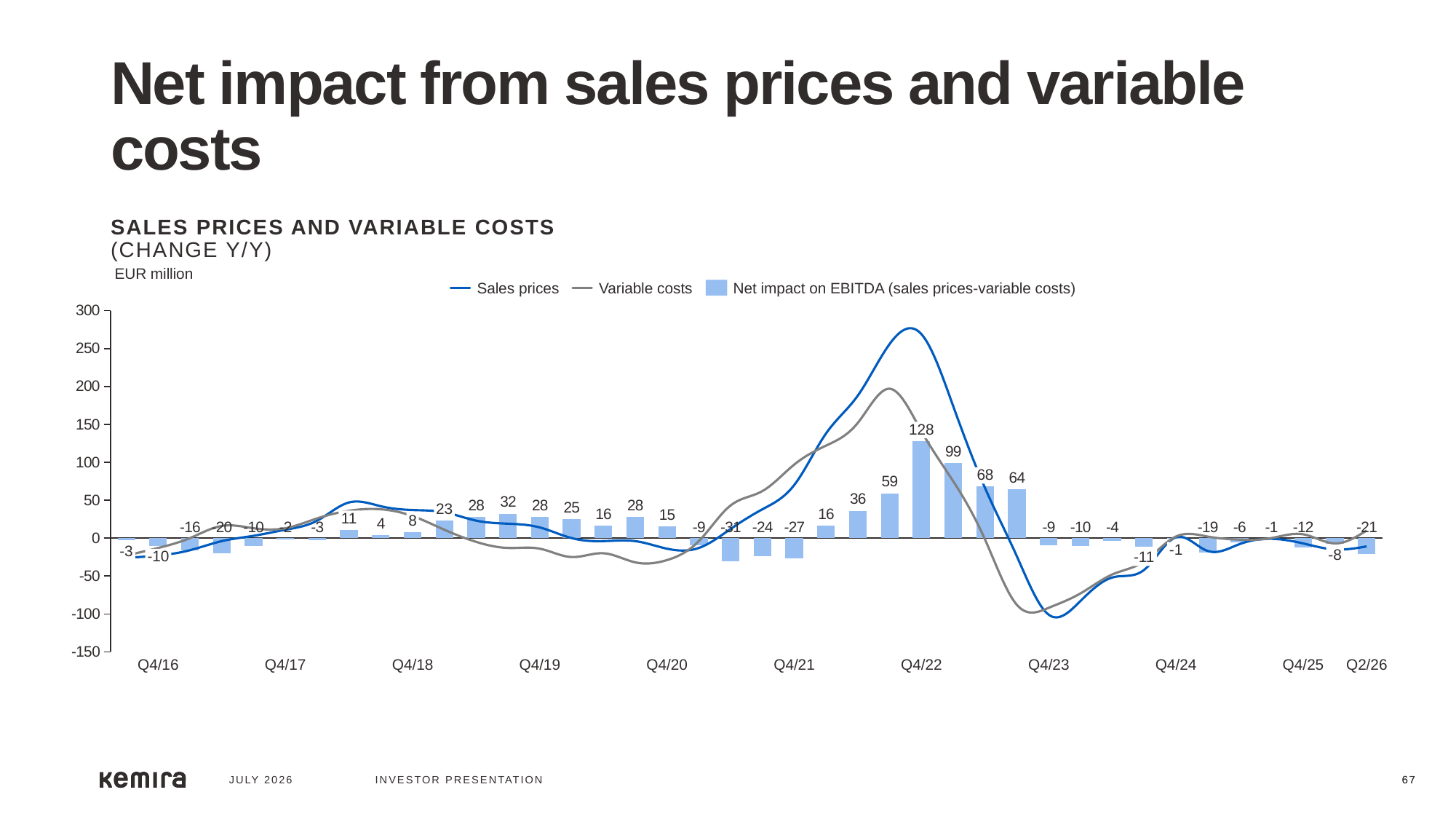
What is the difference between the net impact on EBITDA for Q4/22 and Q4/23? 137 What is the net impact on EBITDA value for Q4/19? 28 Is the Sales prices line value at Q4/23 greater or less than -50? less How many series does the legend list? 3 What is the lowest net impact on EBITDA value shown on the bars? -31 In which quarter is the net impact on EBITDA bar highest? Q4/22 What is the net impact on EBITDA value for Q4/23? -9 What unit is the chart measured in? EUR million What is the net impact on EBITDA value for Q2/26? -21 Is the Sales prices line value at Q4/22 greater or less than 250? greater Which is larger, the net impact on EBITDA for Q4/19 or for Q4/20? Q4/19 What is the net impact on EBITDA value for Q4/22? 128